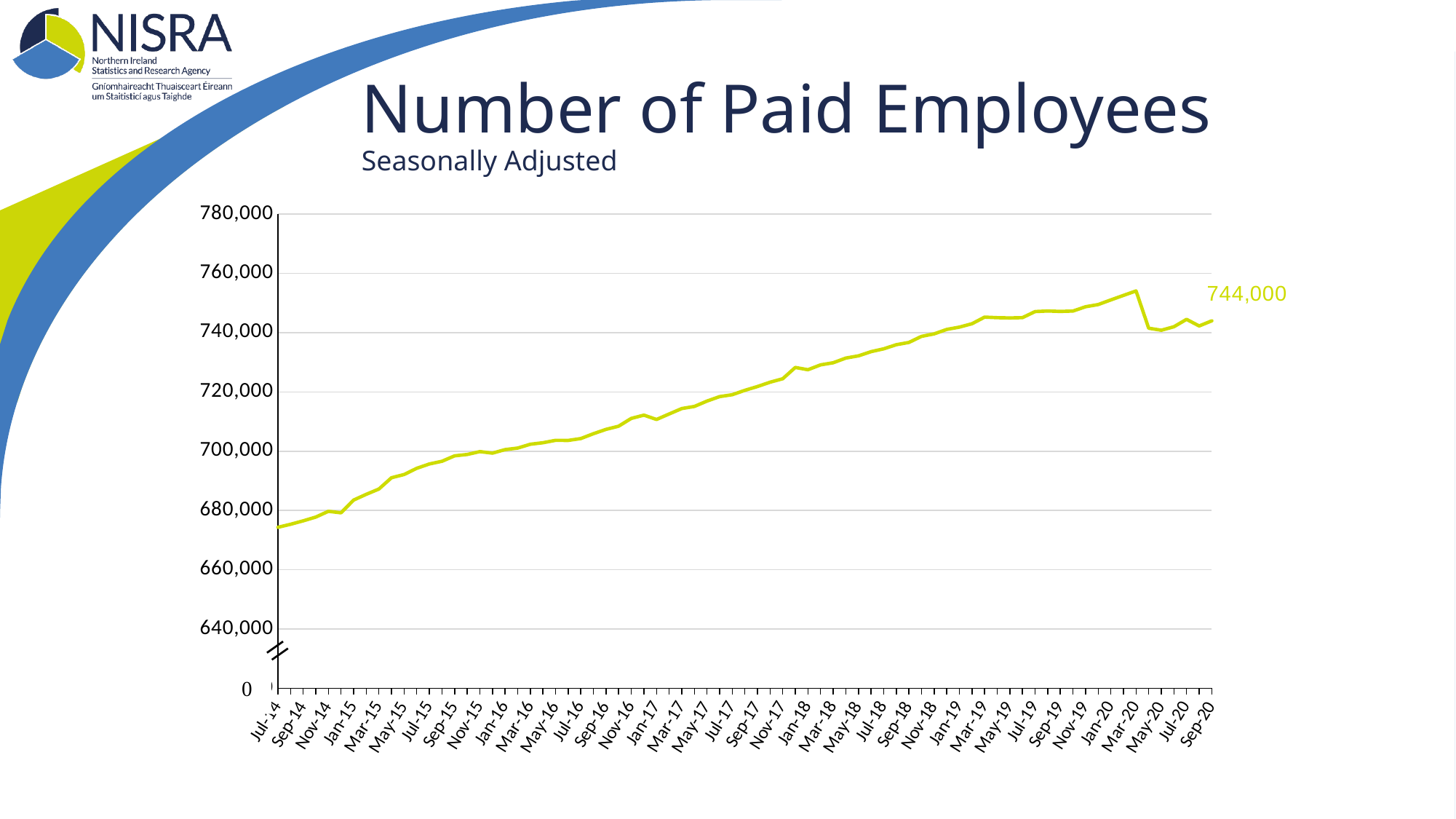
Is the value for Jul-14 greater or less than 680,000? less Do the values rise or fall between Mar-20 and May-20? Fall Is the value for Jan-17 greater or less than 700,000? greater Is the value for Mar-20 greater or less than 740,000? greater Which is larger, the value for Mar-20 or the value for Sep-20? Mar-20 What is the number of paid employees shown for Sep-20? 744,000 What kind of chart is used to show the number of paid employees? Line chart Overall, do the values rise or fall from Jul-14 to Mar-20? Rise What subtitle appears under the chart title 'Number of Paid Employees'? Seasonally Adjusted At which month is the line at its lowest point? Jul-14 At which month does the line reach its highest point? Mar-20